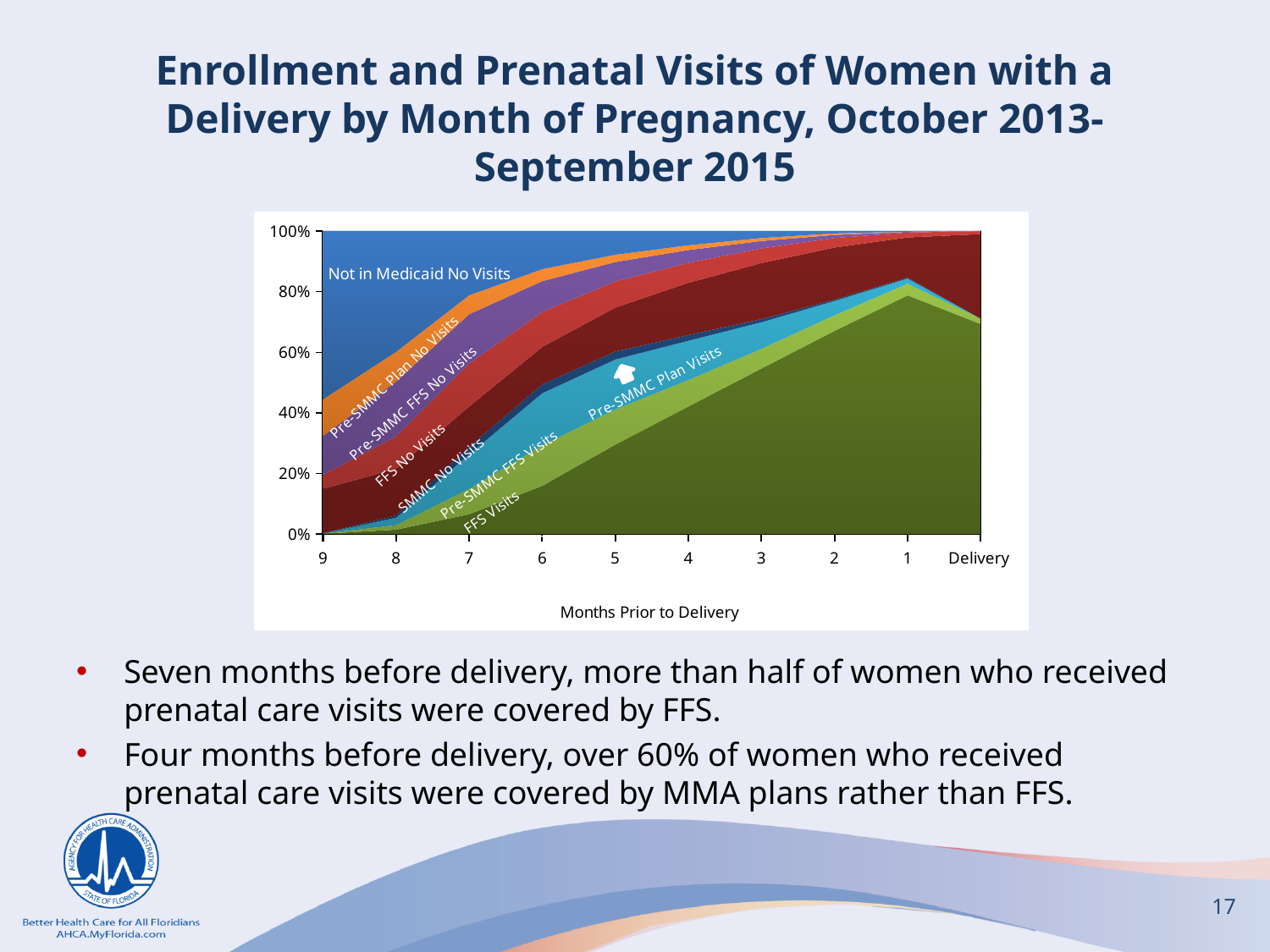
How many points are labeled along the x axis of the chart? 10 Does the FFS Visits area rise or fall from 9 months prior to delivery to 1 month prior to delivery? Rise What is the label of the last category on the x axis of the chart? Delivery At 9 months prior to delivery, is the share for Not in Medicaid No Visits greater or less than 40%? greater At 9 months prior to delivery, is the share for FFS Visits greater or less than 20%? less What is the title of the x axis of the chart? Months Prior to Delivery What is the highest value shown on the y axis of the chart? 100% Does the Not in Medicaid No Visits area grow or shrink as the months move from 9 toward Delivery? Shrink Which series label appears in the top-left area of the chart? Not in Medicaid No Visits What kind of chart is shown on the slide? Stacked area chart